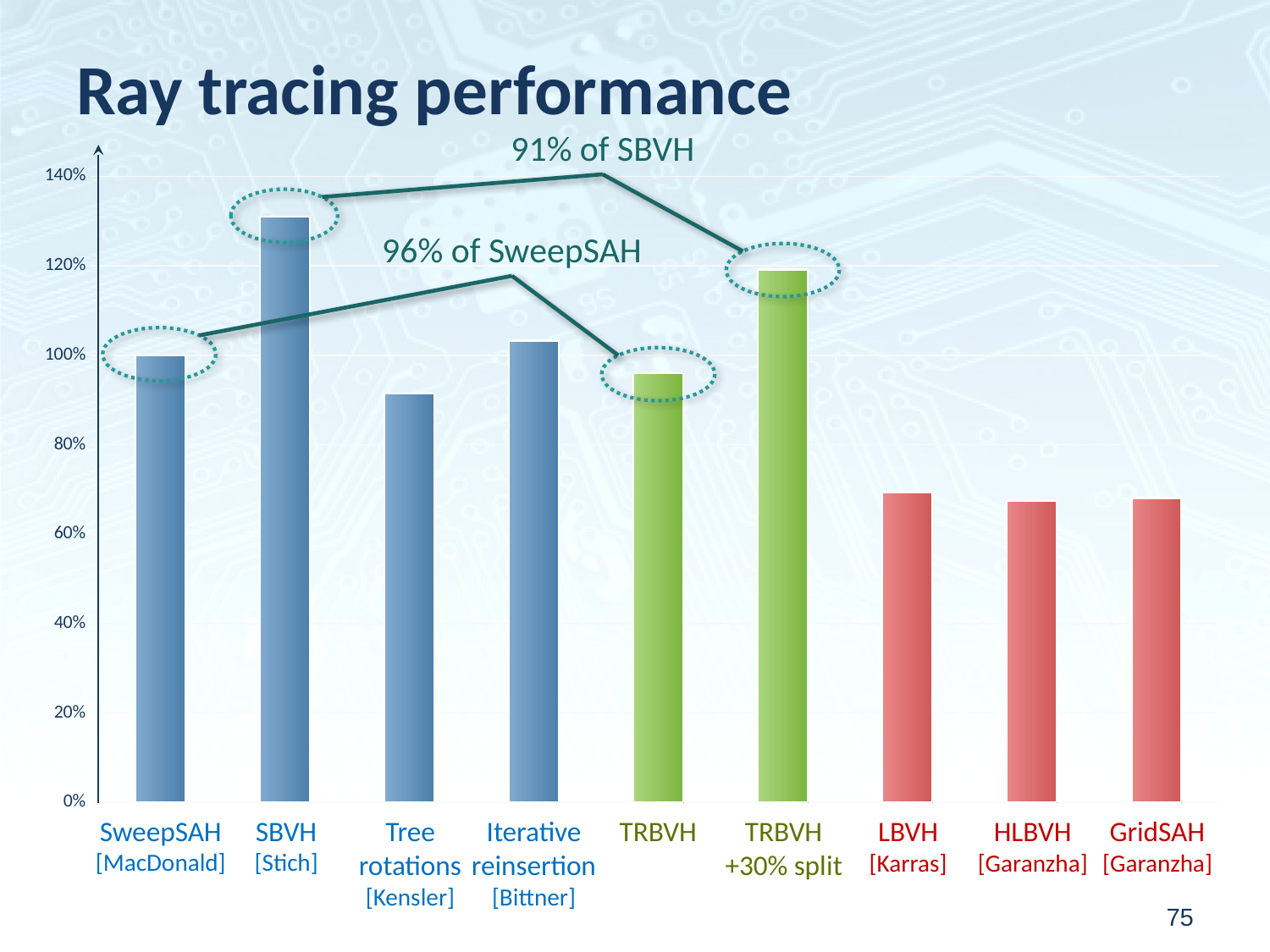
Which method has the highest ray tracing performance in the chart? SBVH Is the value for SBVH greater or less than 120%? greater Is the value for TRBVH +30% split greater or less than 100%? greater Is the value for Tree rotations greater or less than 100%? less Which is larger, the value for SweepSAH or the value for HLBVH? SweepSAH What kind of chart is shown on the slide? bar chart How many bars (methods) are plotted in the chart? 9 Which is larger, the value for SBVH or the value for TRBVH +30% split? SBVH What is the value for SweepSAH? 100% According to the annotation, TRBVH +30% split achieves what percentage of SBVH? 91% of SBVH What is the title of the chart on the slide? Ray tracing performance